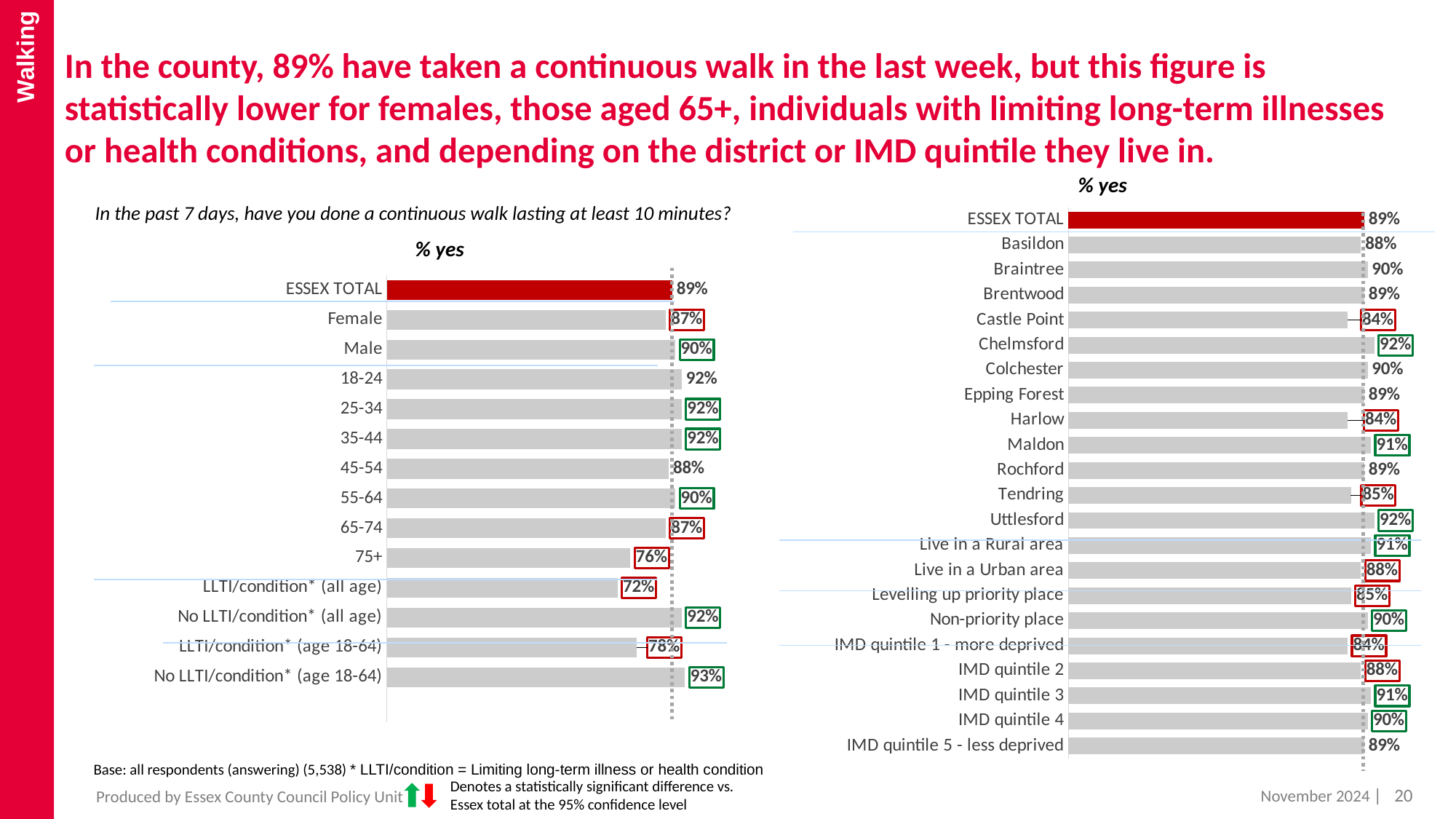
On the left chart, what is the value for Female? 87% On the right chart, which is larger, the value for Live in a Rural area or Live in a Urban area? Live in a Rural area On the left chart, which category has the highest value? No LLTI/condition* (age 18-64) How many categories are plotted on the right chart? 22 On the left chart, which is larger, the value for Male or the value for Female? Male On the left chart, what is the value for 75+? 76% On the right chart, what is the value for Tendring? 85% On the right chart, what is the difference between Chelmsford and Harlow? 8% What type of chart is the left chart? Bar chart On the left chart, what is the difference between No LLTI/condition* (all age) and LLTI/condition* (all age)? 20% On the left chart, which category has the lowest value? LLTI/condition* (all age) On the right chart, what is the value for IMD quintile 3? 91%